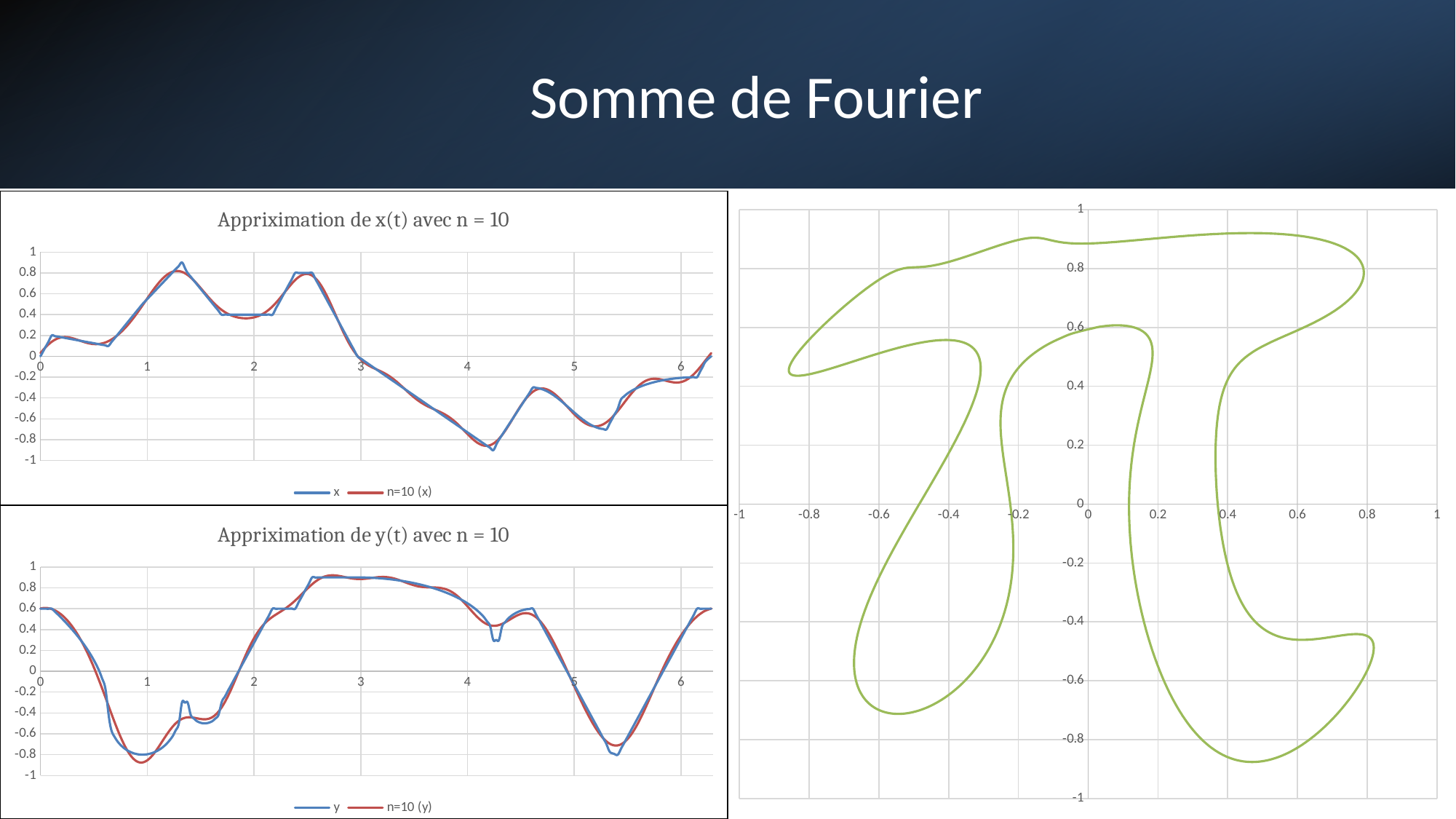
What are the legend entries of the bottom-left chart "Appriximation de y(t) avec n = 10"? y and n=10 (y) In the bottom-left chart "Appriximation de y(t) avec n = 10", is the value of y at t = 1 greater or less than -0.4? less In the bottom-left chart "Appriximation de y(t) avec n = 10", is the value of y at t = 3 greater or less than 0.6? greater What kind of chart is the top-left chart titled "Appriximation de x(t) avec n = 10"? line chart In the top-left chart "Appriximation de x(t) avec n = 10", is the value of x at t = 1 greater or less than 0.4? greater In the top-left chart "Appriximation de x(t) avec n = 10", do the values rise or fall between t = 3 and t = 4? fall In the bottom-left chart "Appriximation de y(t) avec n = 10", do the values rise or fall between t = 0 and t = 1? fall How many lines are plotted in the chart on the right side of the slide? 1 How many series does the legend of the bottom-left chart "Appriximation de y(t) avec n = 10" list? 2 How many series does the legend of the top-left chart "Appriximation de x(t) avec n = 10" list? 2 What are the legend entries of the top-left chart "Appriximation de x(t) avec n = 10"? x and n=10 (x)